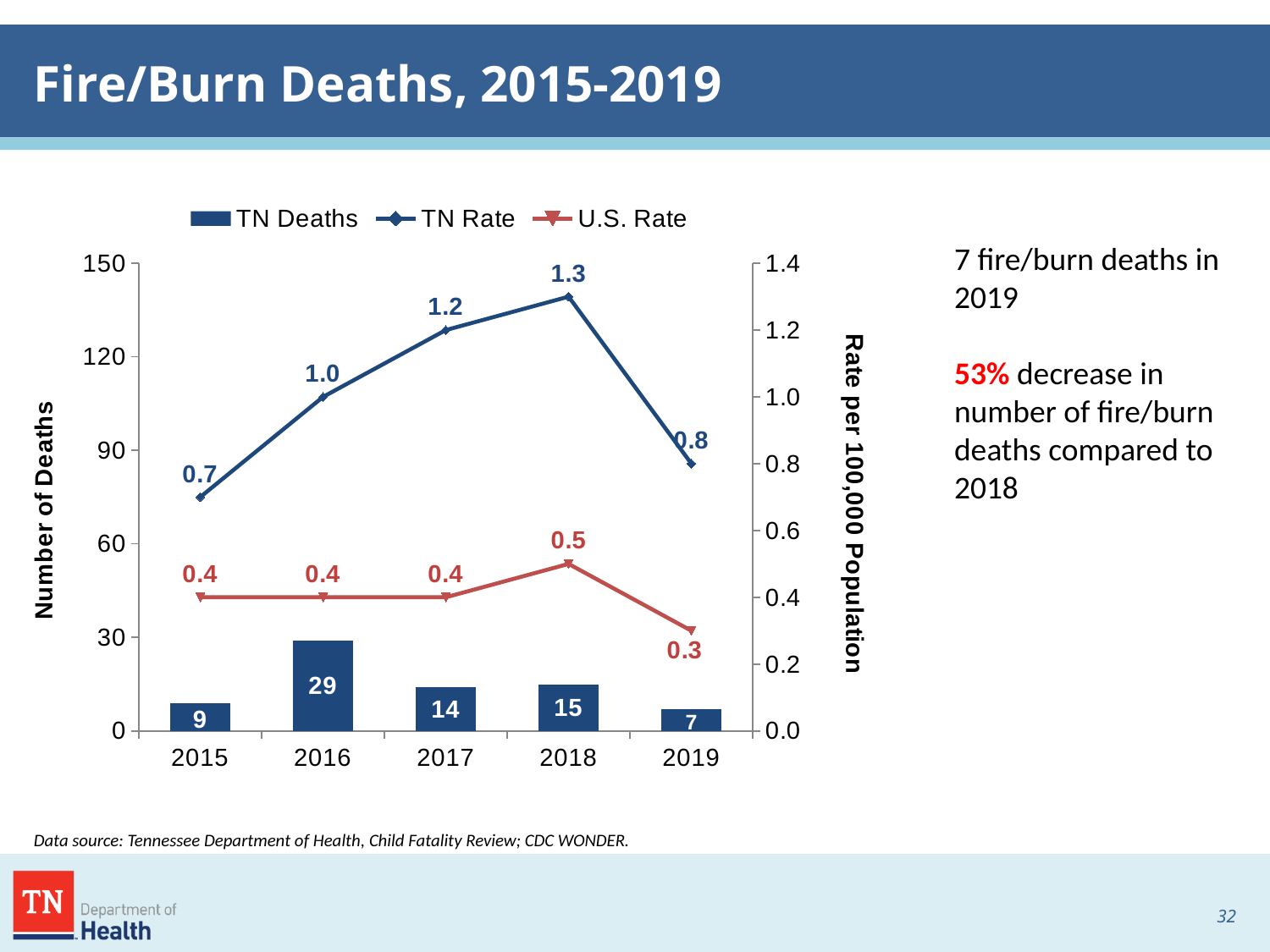
How many series does the legend list? 3 How many TN Deaths were there in 2016? 29 What was the U.S. Rate in 2019? 0.3 Did the TN Rate rise or fall from 2015 to 2018? Rise Which year had the highest number of TN Deaths? 2016 Which is larger in 2017, the TN Rate or the U.S. Rate? TN Rate How many years are shown on the x axis? 5 Which year had the lowest number of TN Deaths? 2019 What is the label of the right-hand vertical axis? Rate per 100,000 Population What was the TN Rate in 2018? 1.3 What kind of chart is used to show TN Deaths? Bar chart What is the difference in TN Deaths between 2018 and 2019? 8